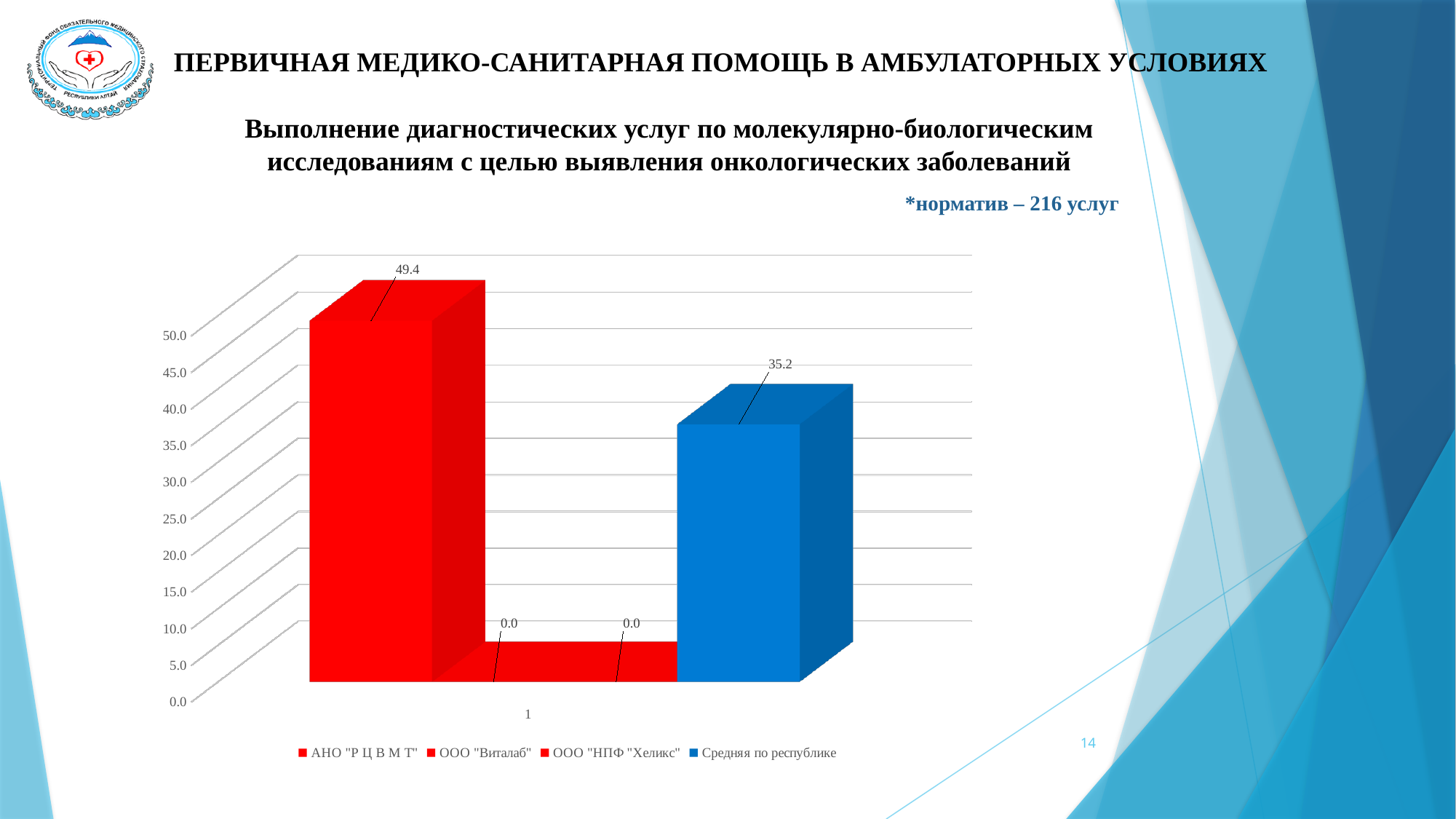
How many series does the legend list? 4 What value is shown for ООО "НПФ "Хеликс"? 0.0 What is the difference between the value for АНО "Р Ц В М Т" and the value for Средняя по республике? 14.2 What colour is the bar for Средняя по республике? Blue What kind of chart is shown on the slide? Bar chart What value is shown for Средняя по республике? 35.2 What value is shown for АНО "Р Ц В М Т"? 49.4 Which is larger, the value for АНО "Р Ц В М Т" or the value for Средняя по республике? АНО "Р Ц В М Т" Is the value for Средняя по республике greater or less than 40.0? less Is the value for АНО "Р Ц В М Т" greater or less than 45.0? greater Which series has the highest value on the chart? АНО "Р Ц В М Т" What value is shown for ООО "Виталаб"? 0.0